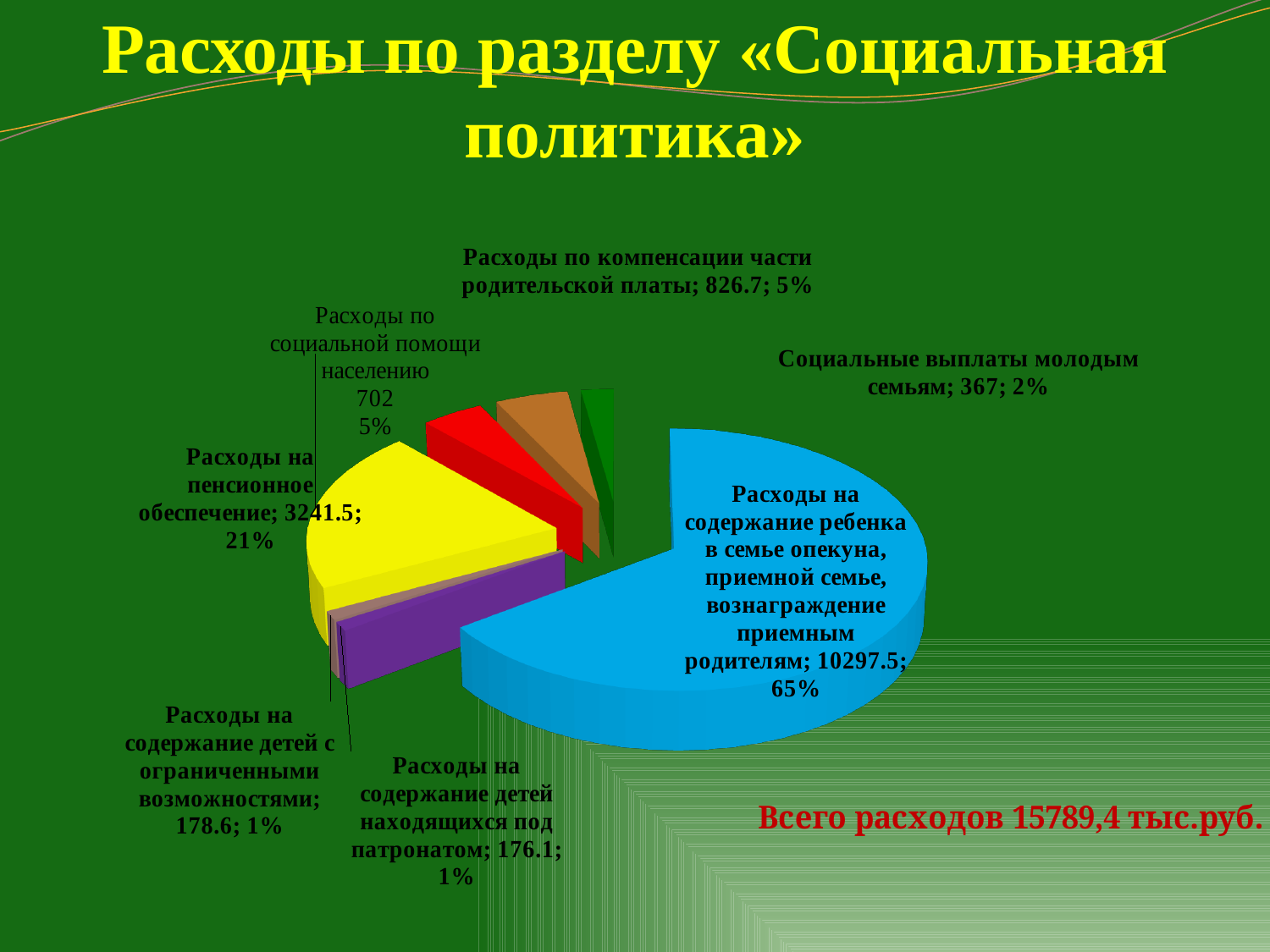
What is the value for «Расходы на содержание детей с ограниченными возможностями»? 178.6 What kind of chart is shown on the slide? pie chart Which category has the smallest value in the pie chart? Расходы на содержание детей находящихся под патронатом What share of the pie is «Расходы на содержание ребенка в семье опекуна, приемной семье, вознаграждение приемным родителям»? 65% What is the value for «Расходы на пенсионное обеспечение»? 3241.5 What is the difference between the values for «Расходы на пенсионное обеспечение» and «Расходы по социальной помощи населению»? 2539.5 Which category has the largest slice of the pie? Расходы на содержание ребенка в семье опекуна, приемной семье, вознаграждение приемным родителям Which is larger: «Расходы по компенсации части родительской платы» or «Социальные выплаты молодым семьям»? Расходы по компенсации части родительской платы What is the value for «Социальные выплаты молодым семьям»? 367 What total expenditure is stated on the slide? 15789,4 тыс.руб. What share of the pie is «Расходы по компенсации части родительской платы»? 5% How many slices does the pie chart have? 7